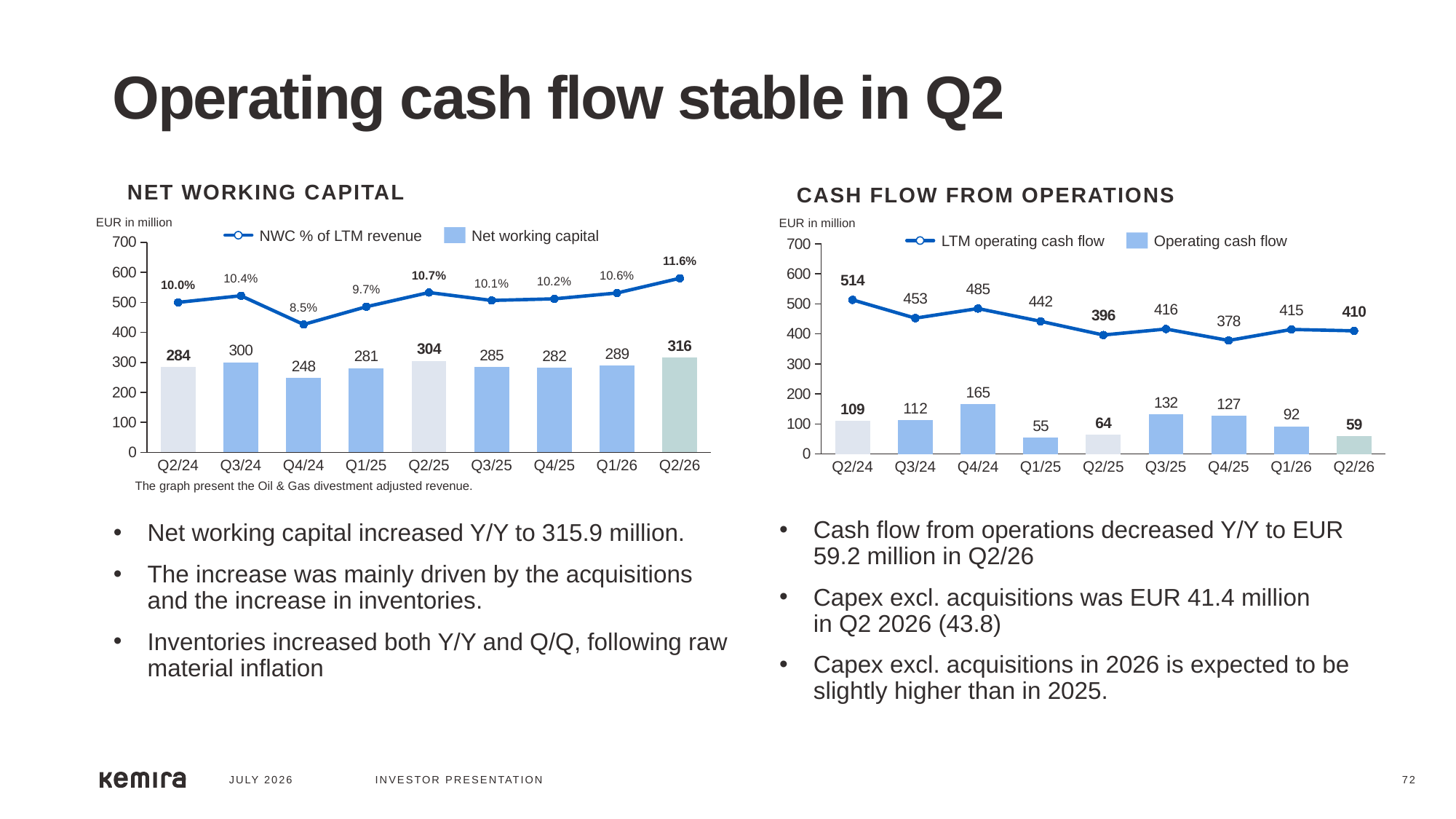
In the Cash Flow From Operations chart, what is the difference in operating cash flow between Q2/24 and Q2/26? 50 In the Cash Flow From Operations chart, is the operating cash flow for Q3/25 larger or smaller than for Q4/25? larger In the Net Working Capital chart, how many series does the legend list? 2 In the Net Working Capital chart, what is the difference in net working capital between Q2/26 and Q2/24? 32 In the Net Working Capital chart, what is the NWC % of LTM revenue for Q4/24? 8.5% In the Cash Flow From Operations chart, what is the operating cash flow for Q1/25? 55 In the Cash Flow From Operations chart, what is the LTM operating cash flow for Q2/26? 410 In the Cash Flow From Operations chart, which quarter has the highest LTM operating cash flow? Q2/24 In the Cash Flow From Operations chart, which quarter has the highest operating cash flow? Q4/24 In the Cash Flow From Operations chart, how many quarters are shown on the x axis? 9 In the Net Working Capital chart, which quarter has the lowest net working capital? Q4/24 In the Net Working Capital chart, what is the net working capital for Q2/26? 316